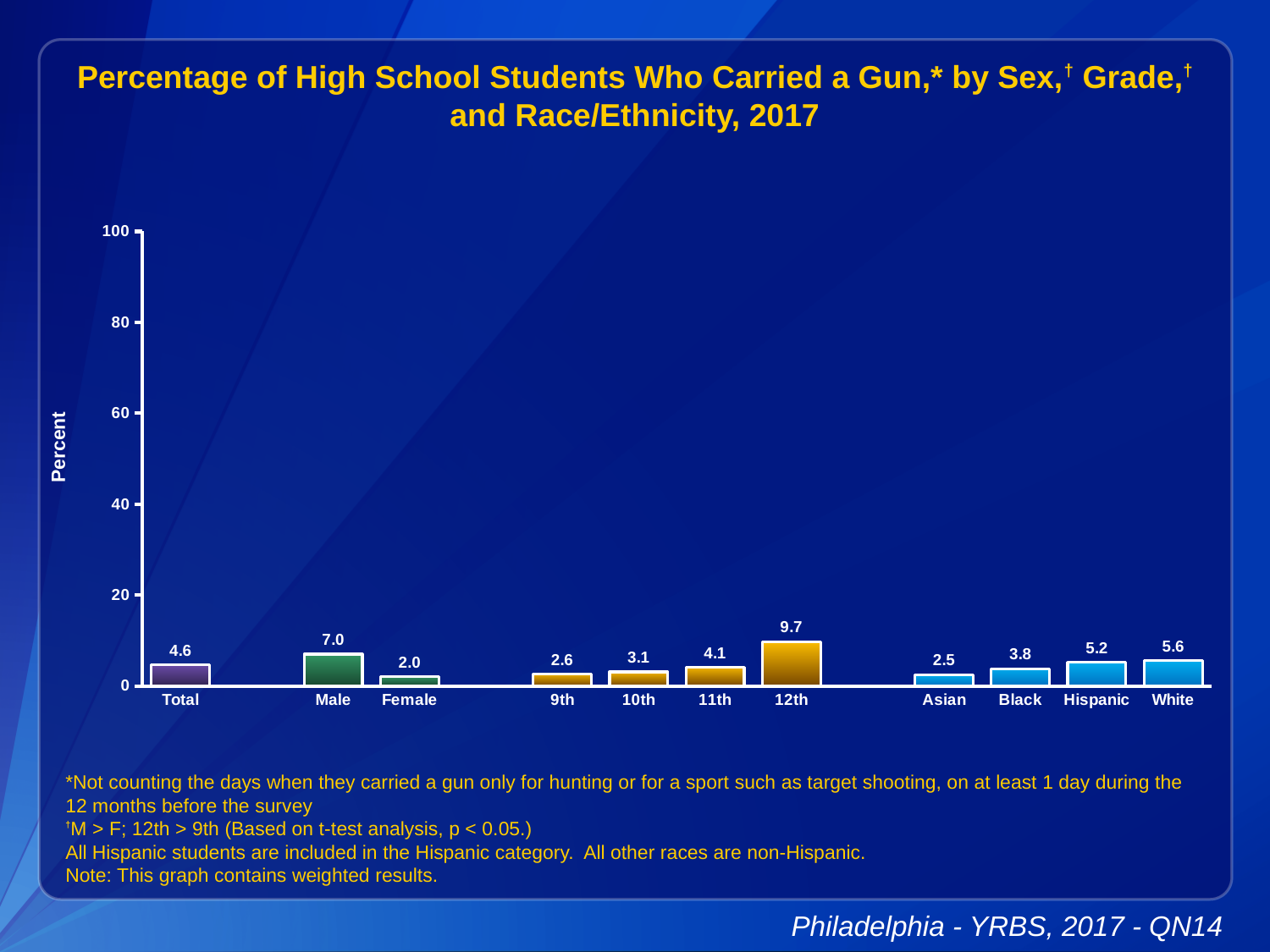
What is the difference between the 12th and 9th grade values? 7.1 What is the value for Hispanic? 5.2 Is the value for 12th grade greater or less than 20? less What is the difference between the Male and Female values? 5.0 Which category has the highest value? 12th What is the value for 12th grade? 9.7 What kind of chart is this? bar chart What is the value for Total? 4.6 Which category has the lowest value? Female What is the value for Male? 7.0 Which is larger, the value for White or the value for Black? White How many categories are shown on the x axis? 11